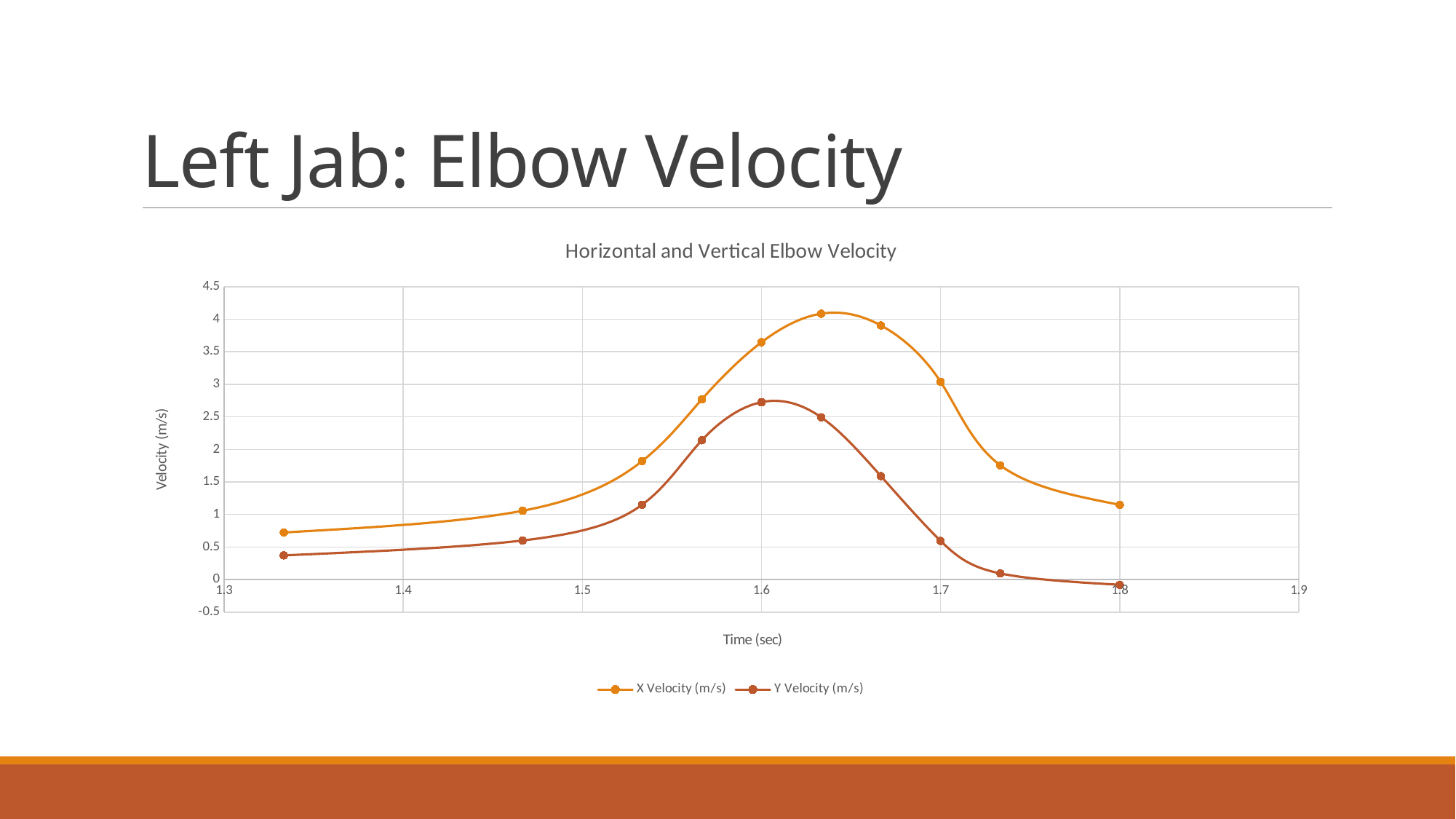
What is the title of the chart? Horizontal and Vertical Elbow Velocity How many series does the legend list? 2 Does the X Velocity (m/s) series rise or fall between 1.6 sec and 1.8 sec? fall At time 1.6 sec, which series has the larger value, X Velocity (m/s) or Y Velocity (m/s)? X Velocity (m/s) What is the label of the x axis? Time (sec) Which series reaches the higher peak velocity? X Velocity (m/s) Is the Y Velocity (m/s) value at 1.6 sec greater or less than 2.5? greater Is the Y Velocity (m/s) value at 1.8 sec greater or less than 0.5? less How many data points are plotted for the X Velocity (m/s) series? 10 Is the X Velocity (m/s) value at 1.6 sec greater or less than 3.5? greater What kind of chart is shown on the slide? Line chart